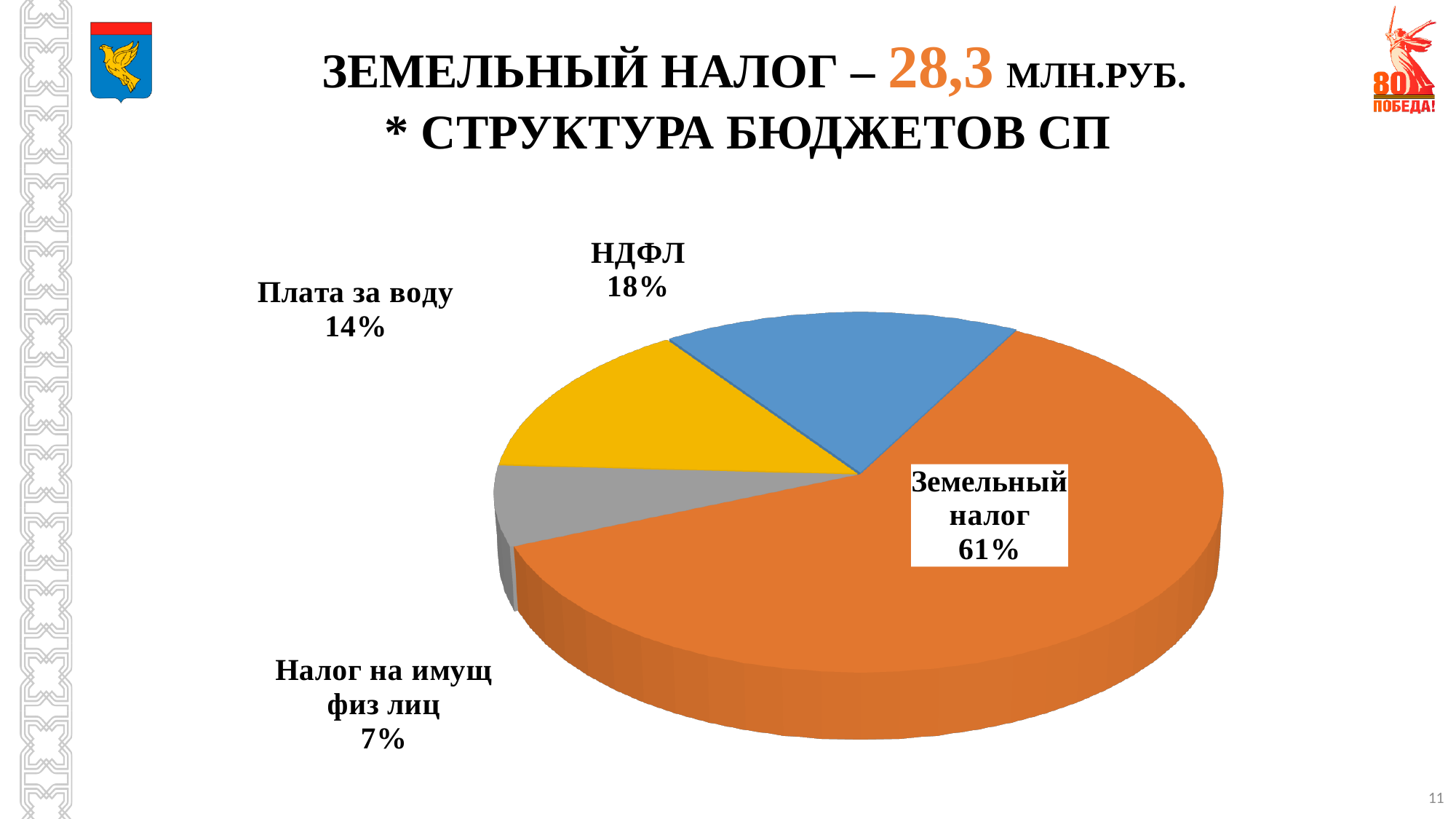
Which is larger, НДФЛ or Плата за воду? НДФЛ Which category has the largest slice of the pie? Земельный налог What is the value shown for НДФЛ? 18% What share of the pie does Земельный налог take? 61% What kind of chart is shown on the slide? Pie chart What is the value shown for Плата за воду? 14% How many slices does the pie chart have? 4 What is the difference in percentage points between Земельный налог and НДФЛ? 43 What colour is the slice for Земельный налог? Orange Which category has the smallest slice of the pie? Налог на имущ физ лиц What is the difference in percentage points between Плата за воду and Налог на имущ физ лиц? 7 What is the value shown for Налог на имущ физ лиц? 7%